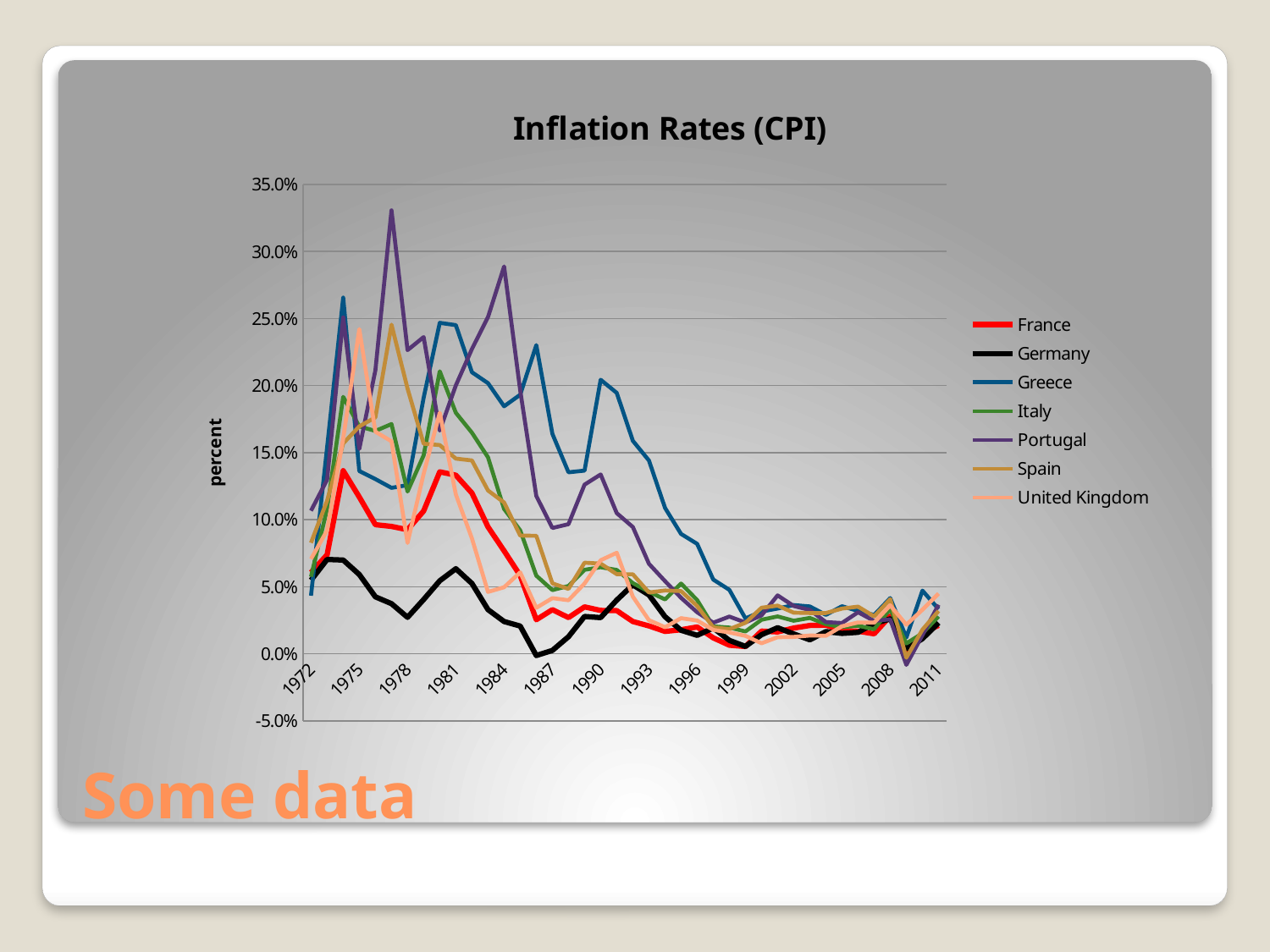
Do the values for Greece generally rise or fall from 1990 to 2011? fall How many year labels are shown on the horizontal axis? 14 What is the title of the chart? Inflation Rates (CPI) Which series reaches the highest value anywhere on the chart? Portugal Is the value for Greece in 1974 greater or less than 25.0%? greater Is the peak value for Portugal greater or less than 30.0%? greater How many series does the legend list? 7 Is the value for Germany in 1981 greater or less than 10.0%? less What is the label on the vertical axis? percent Which series is generally the lowest during the 1970s? Germany What kind of chart is shown on the slide? line chart